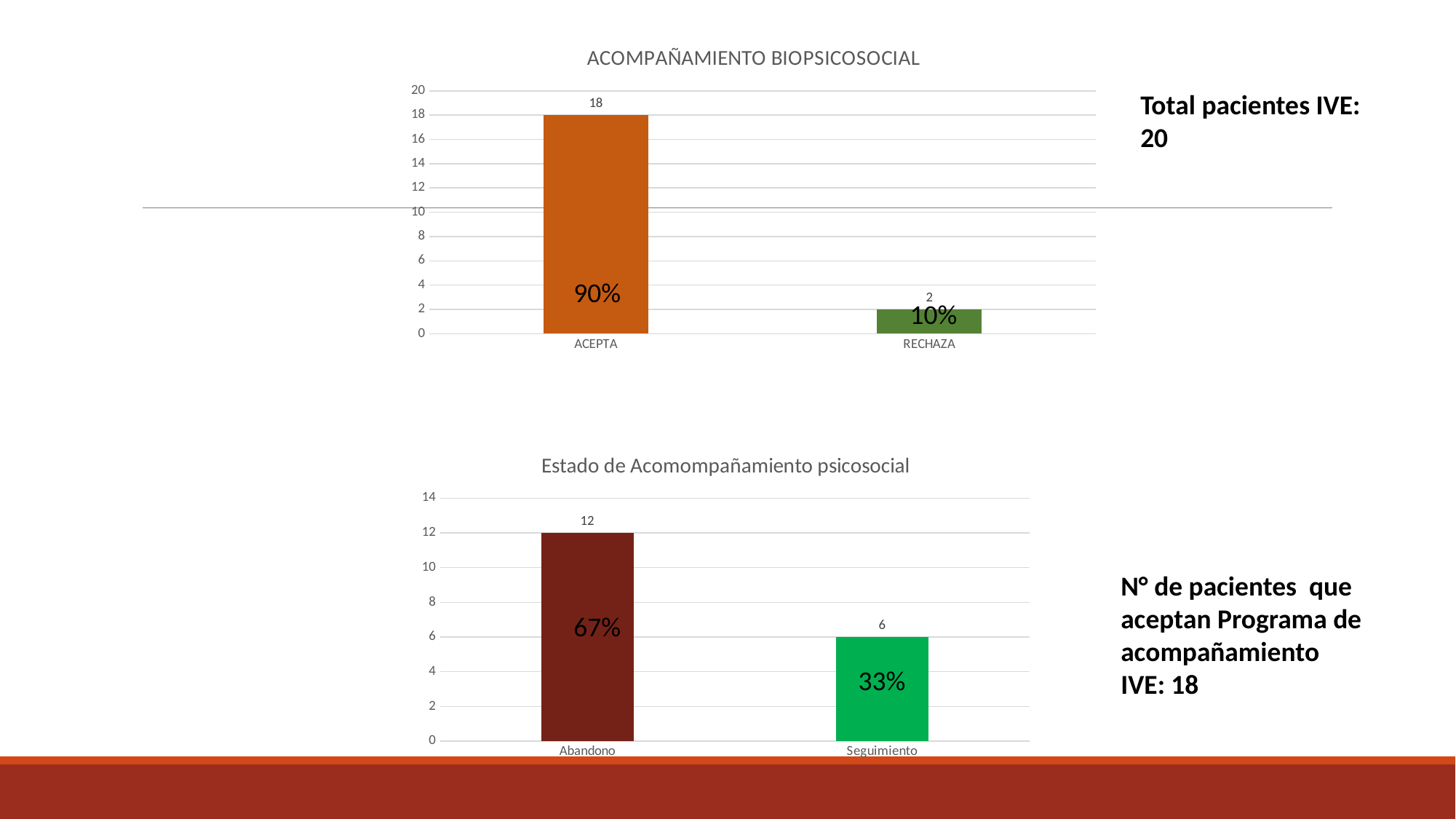
In the 'Estado de Acomompañamiento psicosocial' chart, what percentage label is shown on the Seguimiento bar? 33% In the 'Estado de Acomompañamiento psicosocial' chart, what is the value for Seguimiento? 6 In the 'ACOMPAÑAMIENTO BIOPSICOSOCIAL' chart, how many categories are shown? 2 In the 'Estado de Acomompañamiento psicosocial' chart, what is the difference between Abandono and Seguimiento? 6 In the 'Estado de Acomompañamiento psicosocial' chart, what is the value for Abandono? 12 In the 'Estado de Acomompañamiento psicosocial' chart, which category has the lowest value? Seguimiento In the 'ACOMPAÑAMIENTO BIOPSICOSOCIAL' chart, what is the value for ACEPTA? 18 In the 'ACOMPAÑAMIENTO BIOPSICOSOCIAL' chart, which category has the highest value? ACEPTA In the 'ACOMPAÑAMIENTO BIOPSICOSOCIAL' chart, what percentage label is shown on the ACEPTA bar? 90% What type of chart is the 'Estado de Acomompañamiento psicosocial' chart? Bar chart In the 'ACOMPAÑAMIENTO BIOPSICOSOCIAL' chart, what is the value for RECHAZA? 2 In the 'ACOMPAÑAMIENTO BIOPSICOSOCIAL' chart, what is the difference between ACEPTA and RECHAZA? 16